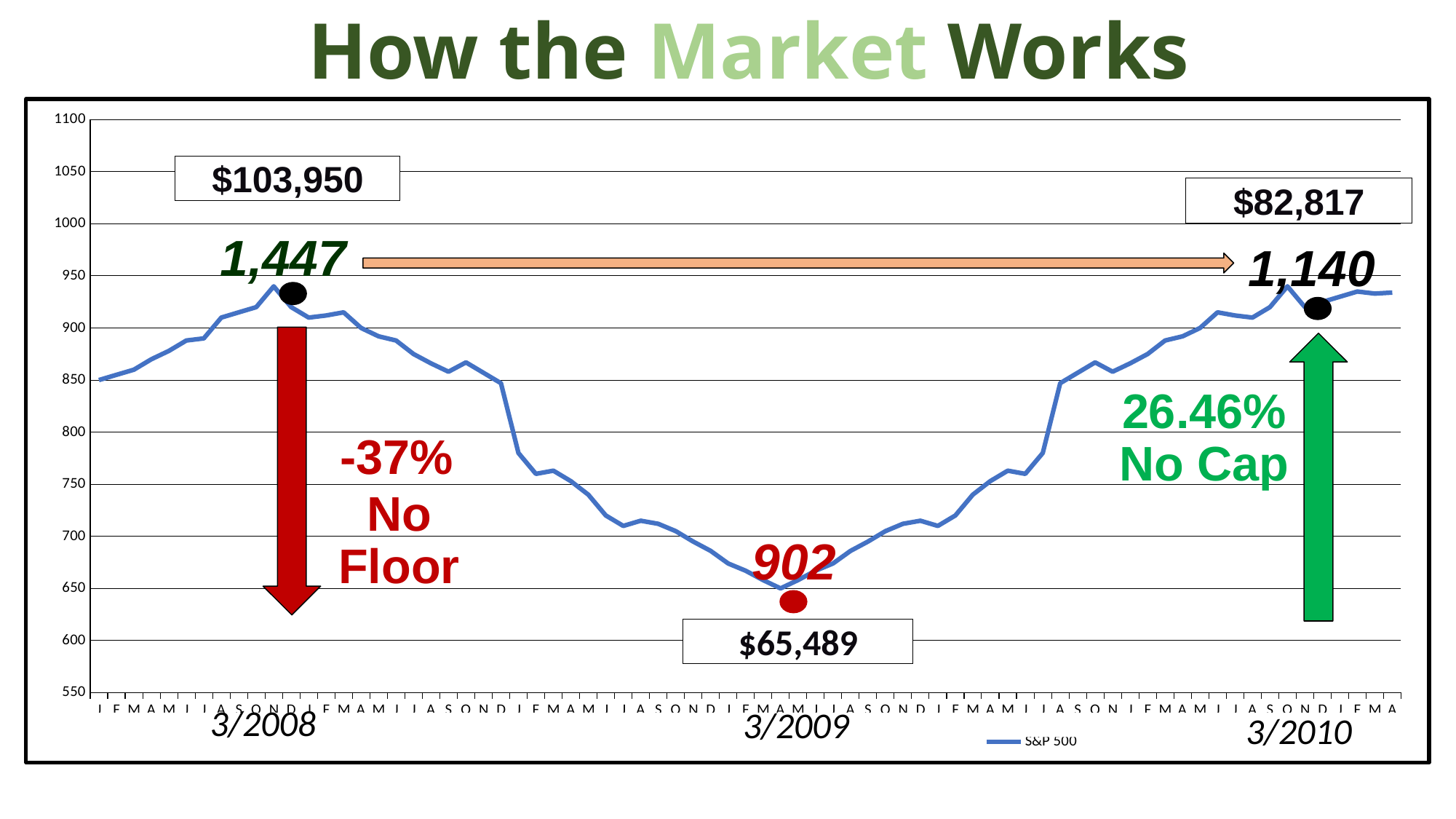
What kind of chart is shown on the slide? line chart What percentage change is labelled next to the red downward arrow? -37% What is the difference between the labelled values at 3/2008 and 3/2009? 545 Does the S&P 500 line rise or fall between 3/2009 and 3/2010? rise Is the labelled value at 3/2008 or at 3/2010 larger? 3/2008 What S&P 500 value is labelled at 3/2008? 1,447 What S&P 500 value is labelled at 3/2010? 1,140 What S&P 500 value is labelled at 3/2009? 902 What dollar amount is shown in the box at 3/2009? $65,489 What series does the legend list for the chart? S&P 500 How many series does the legend list? 1 Which of the three labelled dates has the lowest S&P 500 value? 3/2009